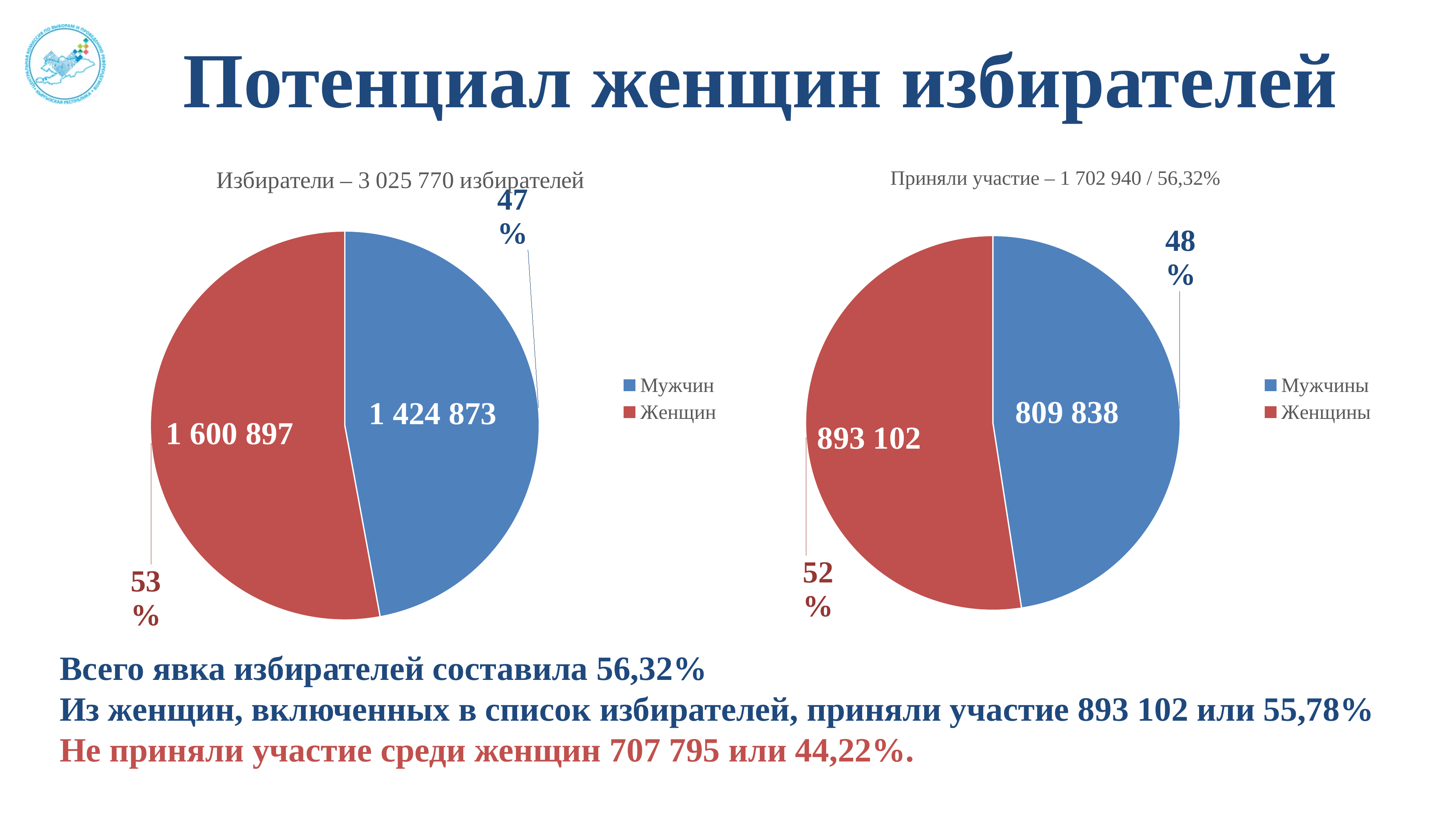
In the right chart (Приняли участие – 1 702 940 / 56,32%), which category has the smaller slice? Мужчины How many entries does the legend of the right chart (Приняли участие – 1 702 940 / 56,32%) list? 2 What type of chart is the left chart (Избиратели – 3 025 770 избирателей)? Pie chart In the right chart (Приняли участие – 1 702 940 / 56,32%), what is the value for Женщины? 893 102 In the right chart (Приняли участие – 1 702 940 / 56,32%), what share of the pie is Мужчины? 48% In the left chart (Избиратели – 3 025 770 избирателей), what is the value for Мужчин? 1 424 873 In the left chart (Избиратели – 3 025 770 избирателей), what share of the pie is Женщин? 53% In the right chart (Приняли участие – 1 702 940 / 56,32%), what is the difference between the values for Женщины and Мужчины? 83 264 In the left chart (Избиратели – 3 025 770 избирателей), what is the difference between the values for Женщин and Мужчин? 176 024 In the left chart (Избиратели – 3 025 770 избирателей), what is the value for Женщин? 1 600 897 In the right chart (Приняли участие – 1 702 940 / 56,32%), what is the value for Мужчины? 809 838 In the left chart (Избиратели – 3 025 770 избирателей), which category has the larger slice? Женщин